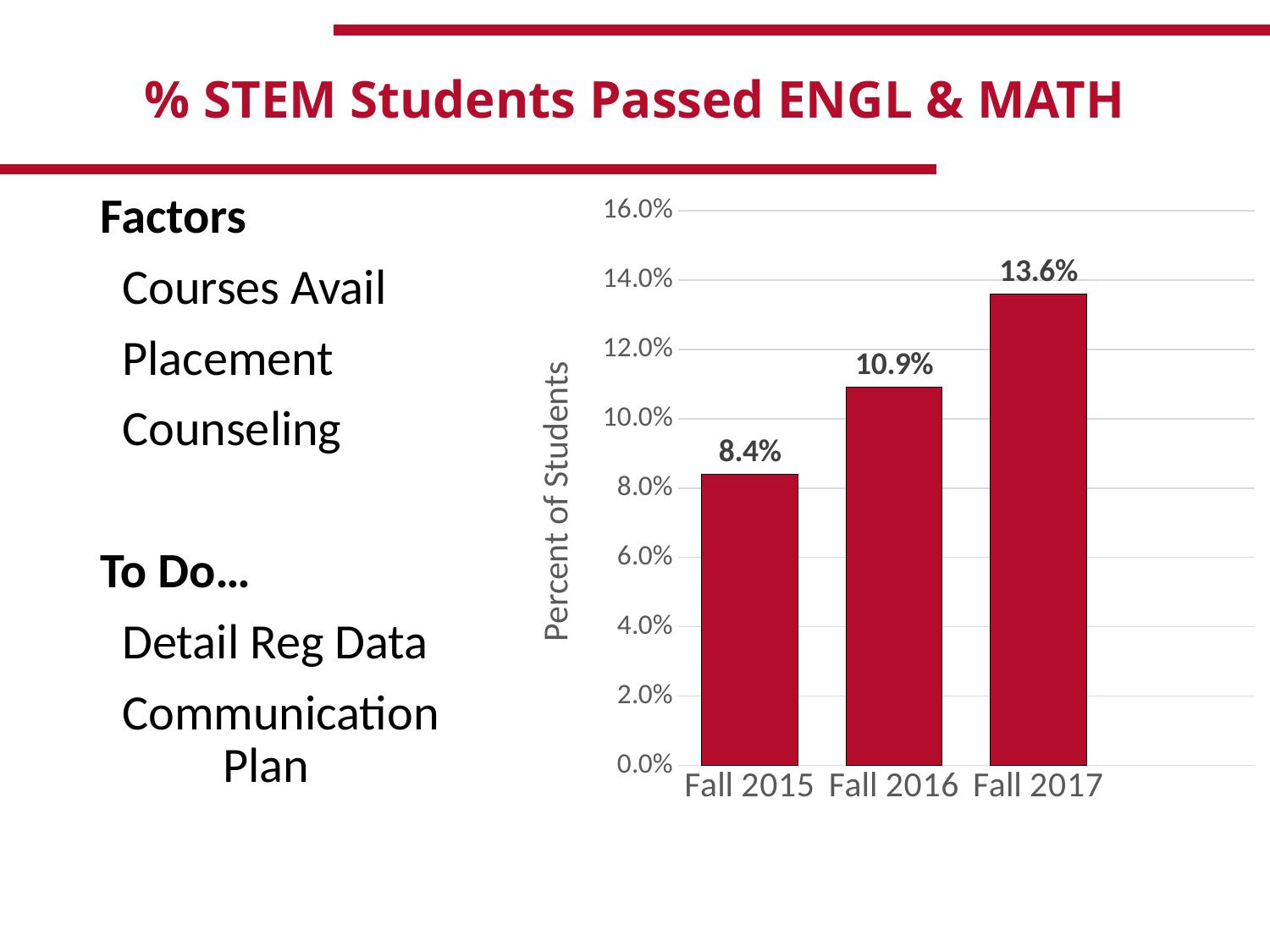
What kind of chart is shown on the slide? Bar chart Which is larger, the value for Fall 2016 or the value for Fall 2017? Fall 2017 Is the value for Fall 2016 greater or less than 10.0%? greater What is the difference between the values for Fall 2017 and Fall 2015? 5.2% What is the value for Fall 2015? 8.4% What is the value for Fall 2017? 13.6% Which term has the highest percentage of STEM students who passed ENGL & MATH? Fall 2017 How many terms are shown on the chart? 3 What is the difference between the values for Fall 2016 and Fall 2015? 2.5% Which term has the lowest percentage of STEM students who passed ENGL & MATH? Fall 2015 Do the values rise or fall from Fall 2015 to Fall 2017? Rise What is the value for Fall 2016? 10.9%